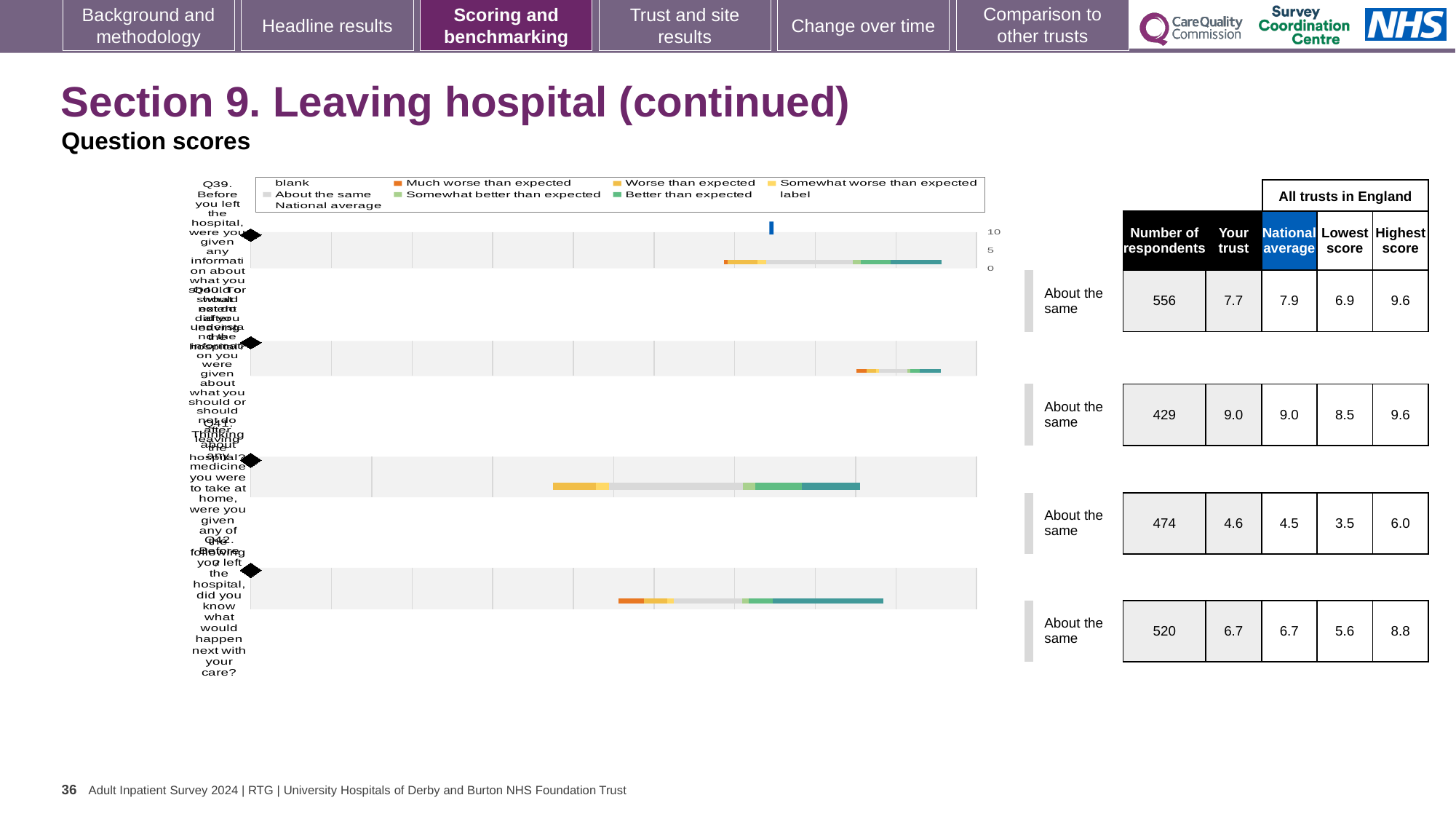
In the table beside the chart, what is the number of respondents for Q39? 556 In the table beside the chart, what is the 'Your trust' score for Q39? 7.7 For Q39, what is the difference between the highest score and the lowest score across all trusts in England? 2.7 In the chart legend, what does the dark teal colour represent? Better than expected What kind of chart is shown on the slide? bar chart Which row of the table has the highest number of respondents? Q39 (556) In the chart legend, what does the orange colour represent? Much worse than expected How many question bars are plotted in the chart? 4 In the table beside the chart, what is the national average for Q42 (the last row)? 6.7 What is the lowest 'Your trust' score shown in the table? 4.6 For Q39, which is larger: the 'Your trust' score or the national average? National average What benchmark category is shown for Q42 (the last row)? About the same